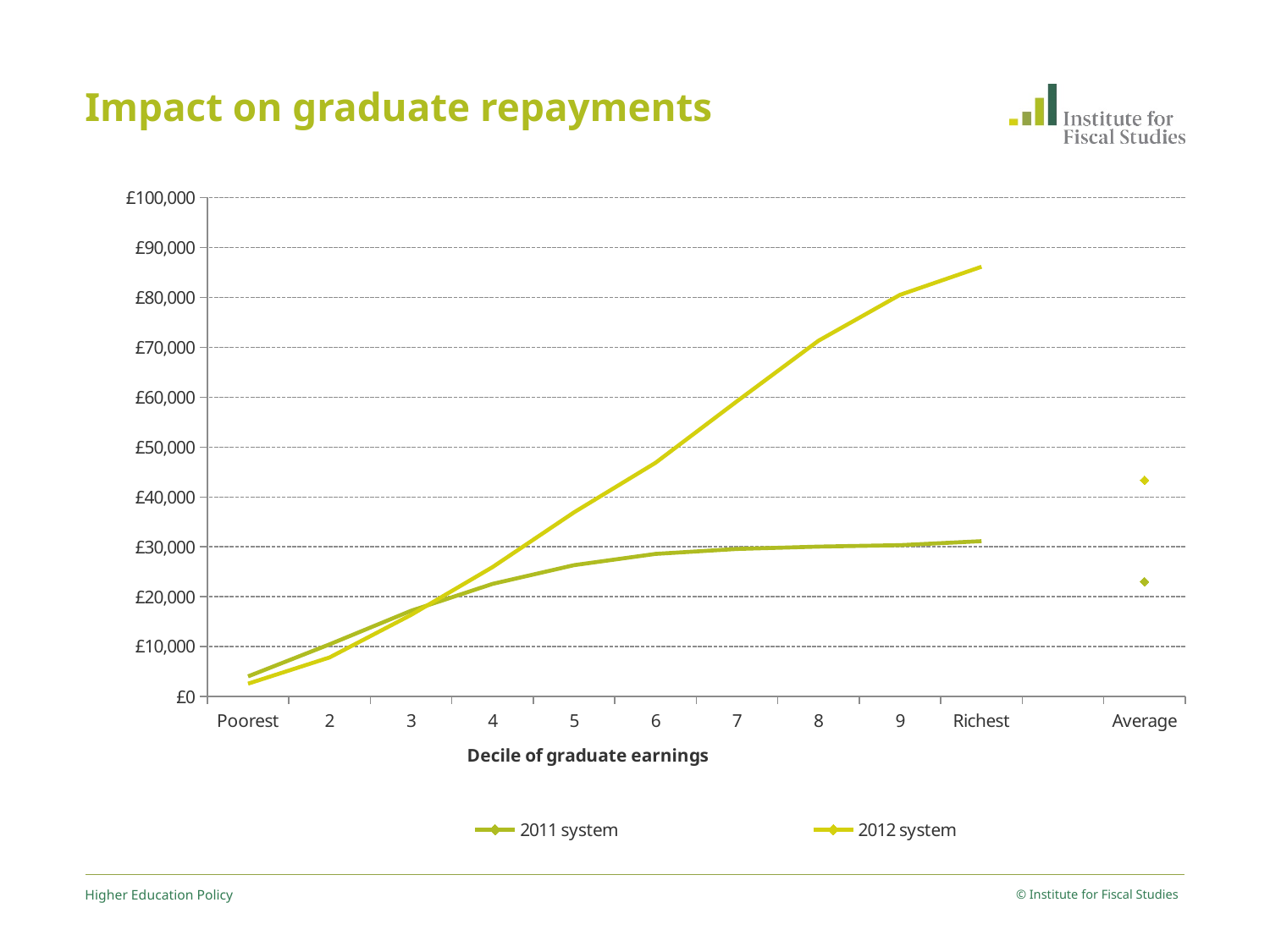
For the 2012 system, which decile has the highest repayment? Richest Is the Average value for the 2011 system greater or less than £30,000? less What is the title of the x axis? Decile of graduate earnings What are the two series named in the legend? 2011 system and 2012 system What kind of chart is shown on the slide? line chart Is the value for the 2012 system at the Richest decile greater or less than £80,000? greater At the Richest decile, which series has the higher repayment: 2011 system or 2012 system? 2012 system Is the value for the 2011 system at the Richest decile greater or less than £40,000? less How many series does the legend list? 2 Do repayments under the 2012 system rise or fall as you move from the Poorest to the Richest decile? rise For the 2012 system, which decile has the lowest repayment? Poorest